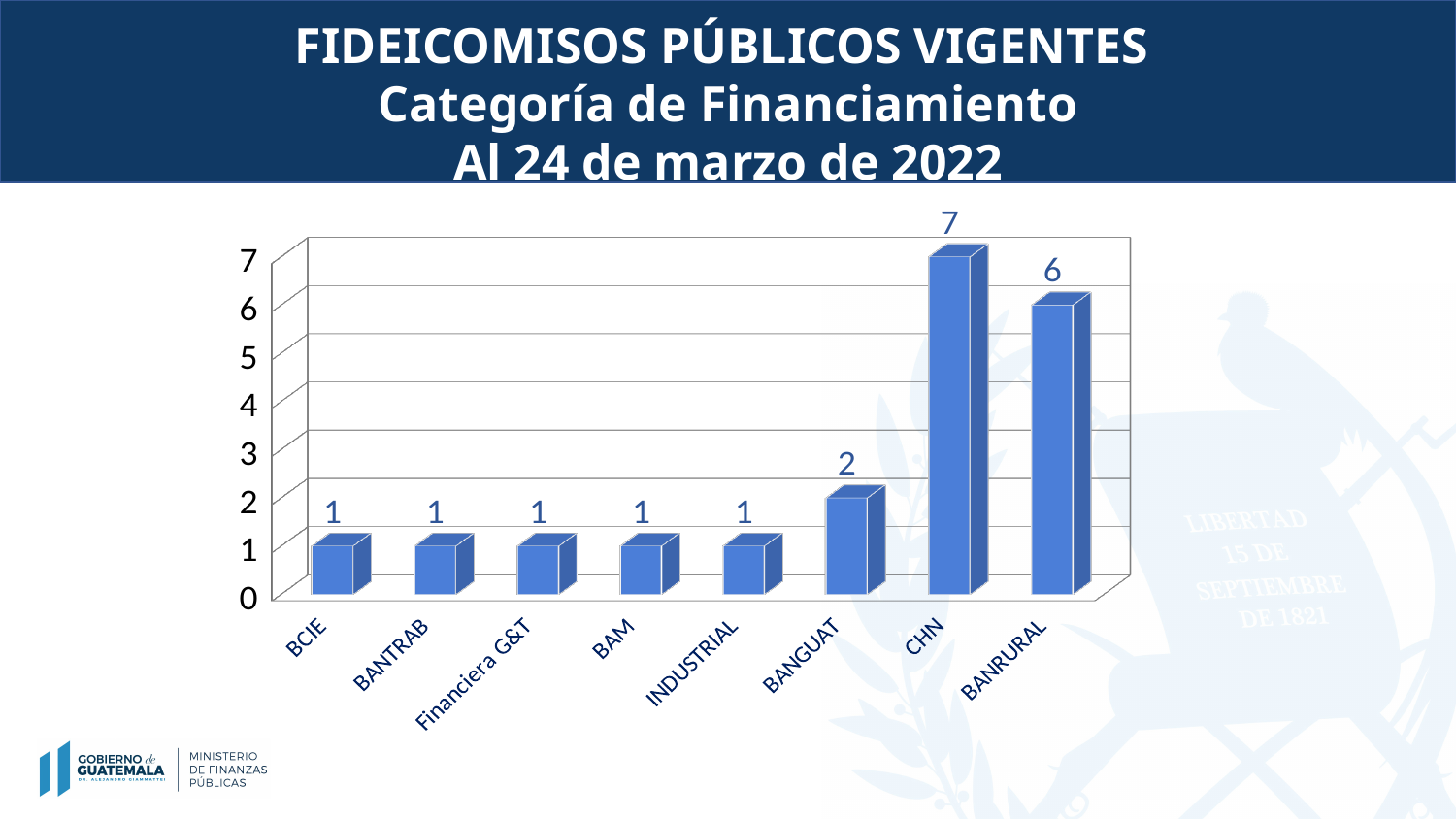
What is the value for BANRURAL? 6 Is the value for CHN greater or less than 5? greater Which is larger, the value for BANGUAT or the value for INDUSTRIAL? BANGUAT What is the difference between the values for BANRURAL and BANGUAT? 4 What kind of chart is shown on the slide? bar chart Which category has the highest value? CHN How many categories are shown on the x axis? 8 What is the value for CHN? 7 How many categories have a value of 1? 5 What is the difference between the values for CHN and BANRURAL? 1 What is the value for BCIE? 1 What is the value for BANGUAT? 2